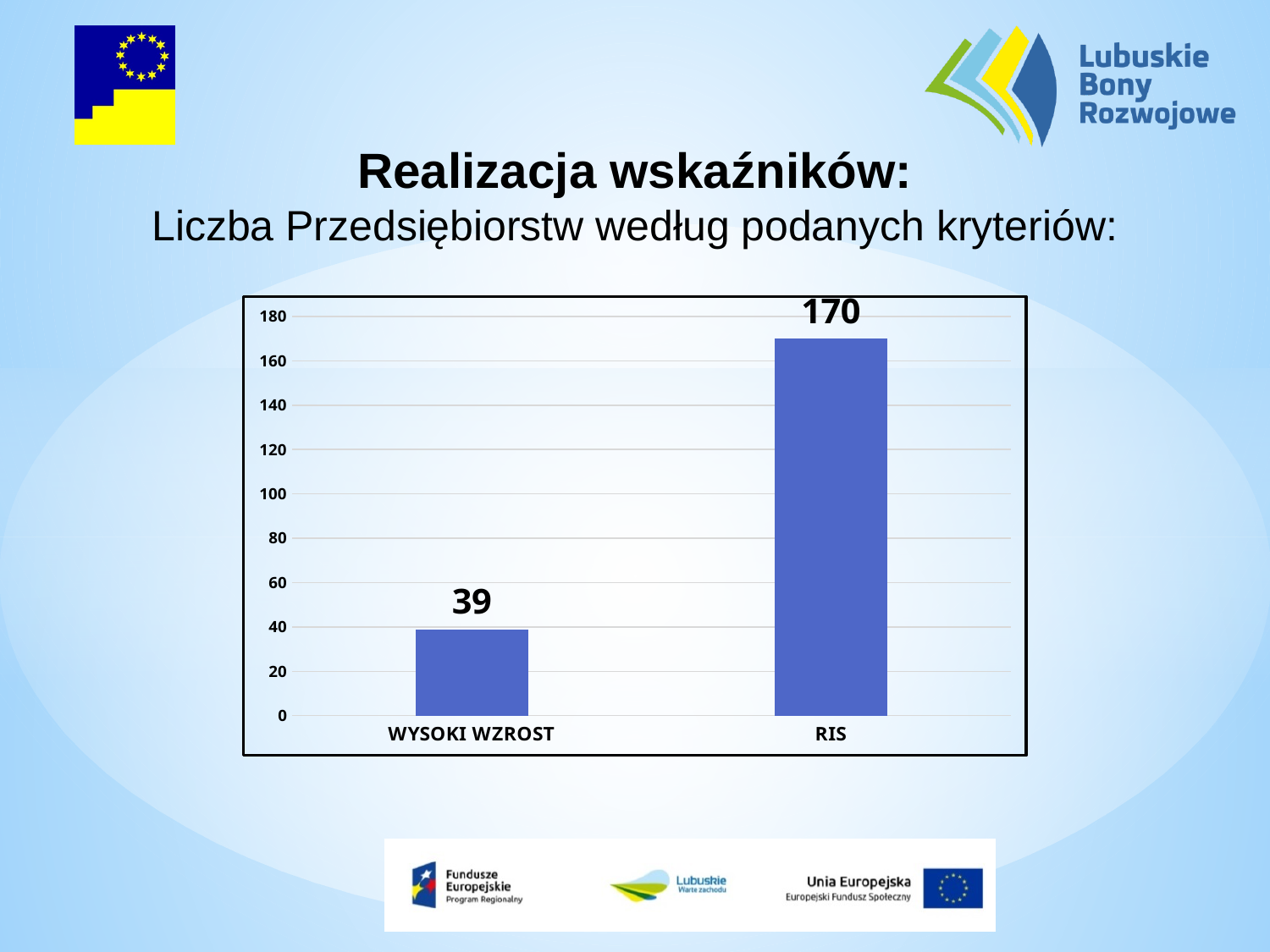
Is the value for RIS greater or less than 160? greater What is the value for RIS? 170 Which category has the lowest value? WYSOKI WZROST How many categories are shown on the x axis? 2 Which is larger, the value for WYSOKI WZROST or the value for RIS? RIS What is the difference between the values for RIS and WYSOKI WZROST? 131 Is the value for WYSOKI WZROST greater or less than 40? less What kind of chart is shown on the slide? bar chart Which category has the highest value? RIS What is the highest value shown on the y axis? 180 What is the value for WYSOKI WZROST? 39 What is the subtitle text above the chart? Liczba Przedsiębiorstw według podanych kryteriów: